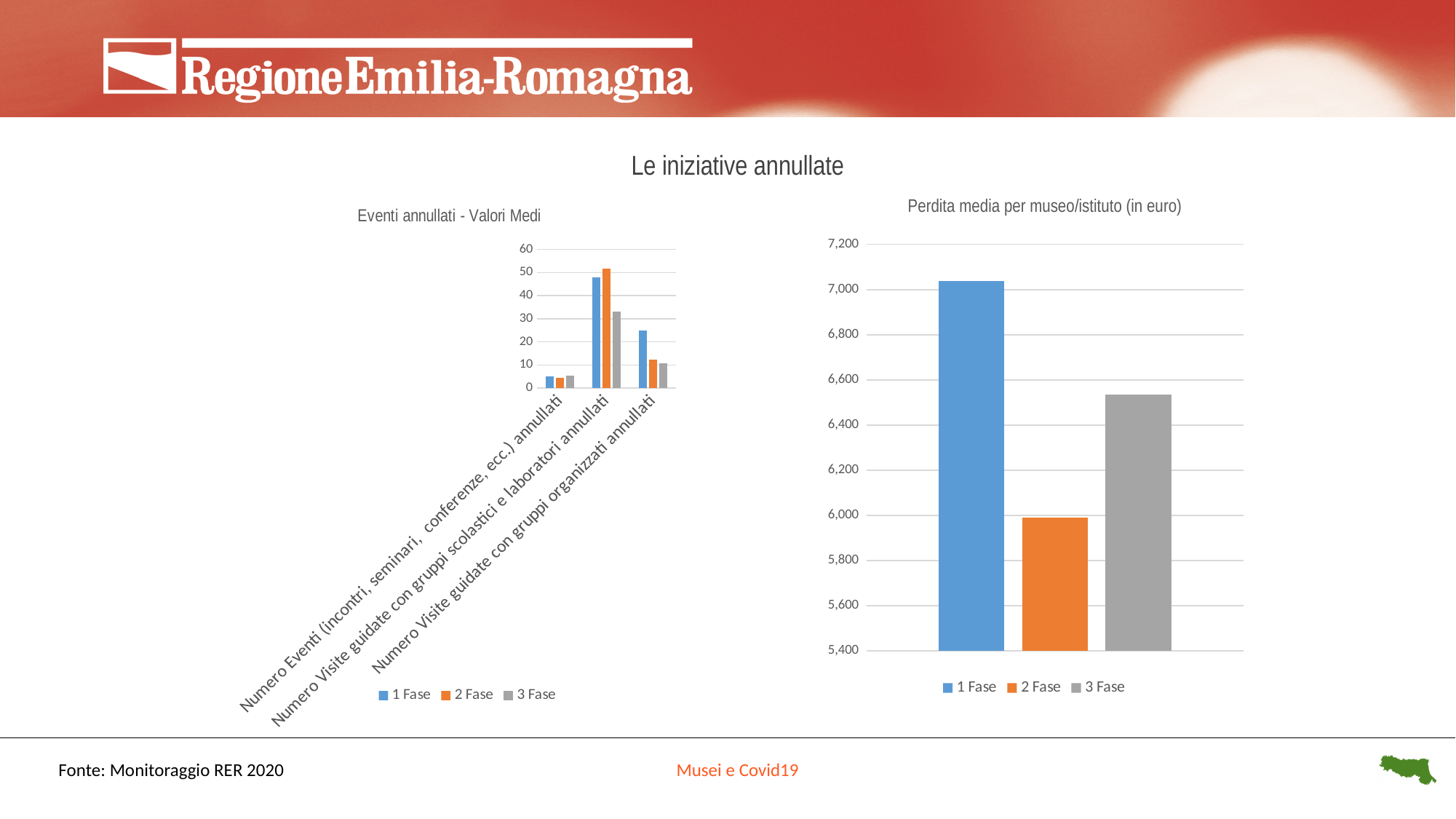
In the 'Perdita media per museo/istituto (in euro)' chart, is the value for 2 Fase greater or less than 6,200? less In the 'Eventi annullati - Valori Medi' chart, which is larger for 1 Fase: 'Numero Visite guidate con gruppi scolastici e laboratori annullati' or 'Numero Visite guidate con gruppi organizzati annullati'? Numero Visite guidate con gruppi scolastici e laboratori annullati What colour represents 2 Fase in the legend of the 'Perdita media per museo/istituto (in euro)' chart? orange In the 'Perdita media per museo/istituto (in euro)' chart, which phase has the highest value? 1 Fase In the 'Perdita media per museo/istituto (in euro)' chart, which phase has the lowest value? 2 Fase How many series does the legend of the 'Eventi annullati - Valori Medi' chart list? 3 In the 'Perdita media per museo/istituto (in euro)' chart, is the value for 1 Fase greater or less than 6,800? greater In the 'Perdita media per museo/istituto (in euro)' chart, is the value for 3 Fase greater or less than 6,400? greater How many categories are shown on the x axis of the 'Eventi annullati - Valori Medi' chart? 3 In the 'Eventi annullati - Valori Medi' chart, which series has the highest bar for 'Numero Visite guidate con gruppi scolastici e laboratori annullati'? 2 Fase What kind of chart is the 'Perdita media per museo/istituto (in euro)' chart? bar chart